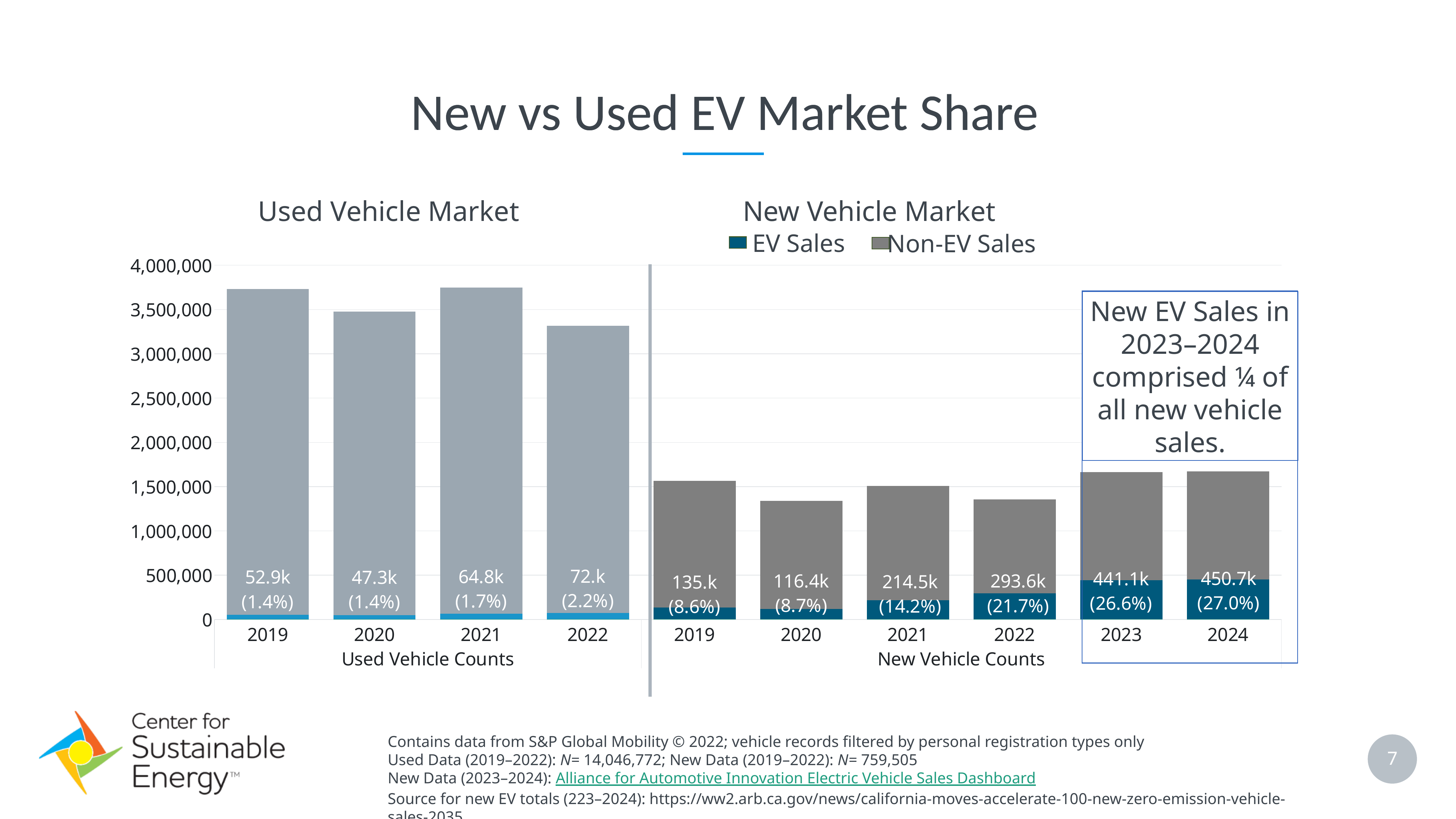
In the New Vehicle Market chart, what is the difference between the EV sales labelled for 2024 and 2023? 9.6k In the Used Vehicle Market chart, is the total bar height for 2022 greater or less than 3,500,000? less In the New Vehicle Market chart, which year has the highest labelled EV sales? 2024 In the New Vehicle Market chart, what is the EV sales value labelled for 2023? 441.1k In the New Vehicle Market chart, which year has the lowest labelled EV sales? 2020 In the Used Vehicle Market chart, what EV market share percentage is shown for 2022? 2.2% In the New Vehicle Market chart, what EV share percentage is shown for 2021? 14.2% How many series does the legend above the New Vehicle Market chart list? 2 In the Used Vehicle Market chart, which year has larger labelled EV sales, 2020 or 2021? 2021 In the New Vehicle Market chart, is the total bar height for 2019 greater or less than 1,500,000? greater In the New Vehicle Market chart, does the EV share percentage rise or fall from 2019 to 2024? rise How many years are shown on the x axis of the New Vehicle Market chart? 6